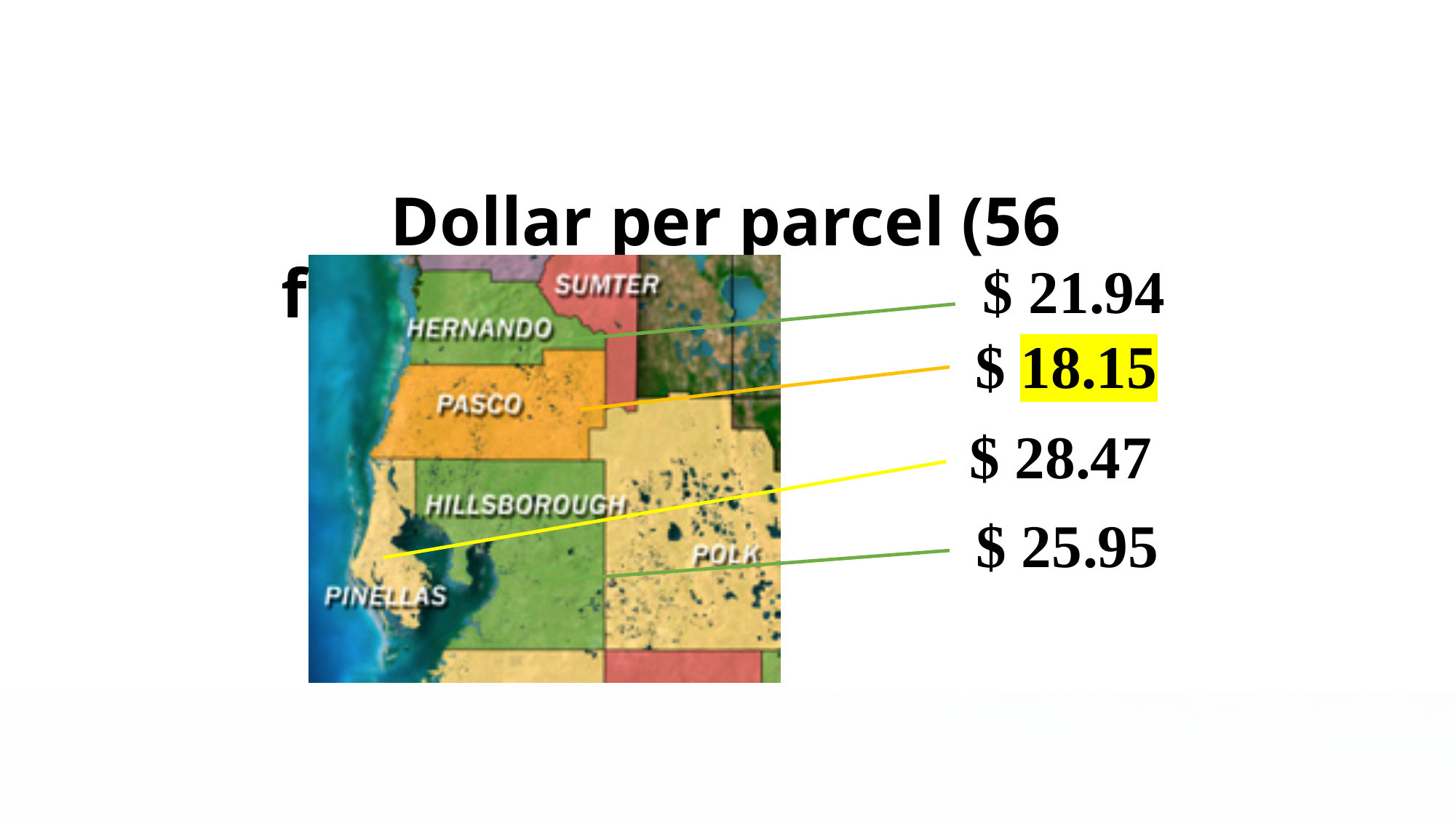
Which county has the highest dollar per parcel value on the slide? Pinellas What is the dollar per parcel value shown for Pasco County? $ 18.15 What is the dollar per parcel value shown for Hillsborough County? $ 25.95 What is the difference between the dollar per parcel values for Pinellas and Pasco? $ 10.32 What is the difference between the dollar per parcel values for Hillsborough and Hernando? $ 4.01 What kind of visual is used to present the dollar per parcel values? An annotated map How many dollar per parcel values are labelled on the map? 4 What is the dollar per parcel value shown for Hernando County? $ 21.94 What is the dollar per parcel value shown for Pinellas County? $ 28.47 Which dollar per parcel value is highlighted in yellow on the slide? $ 18.15 Which county has the lowest dollar per parcel value on the slide? Pasco Which has a higher dollar per parcel value, Hernando or Hillsborough? Hillsborough